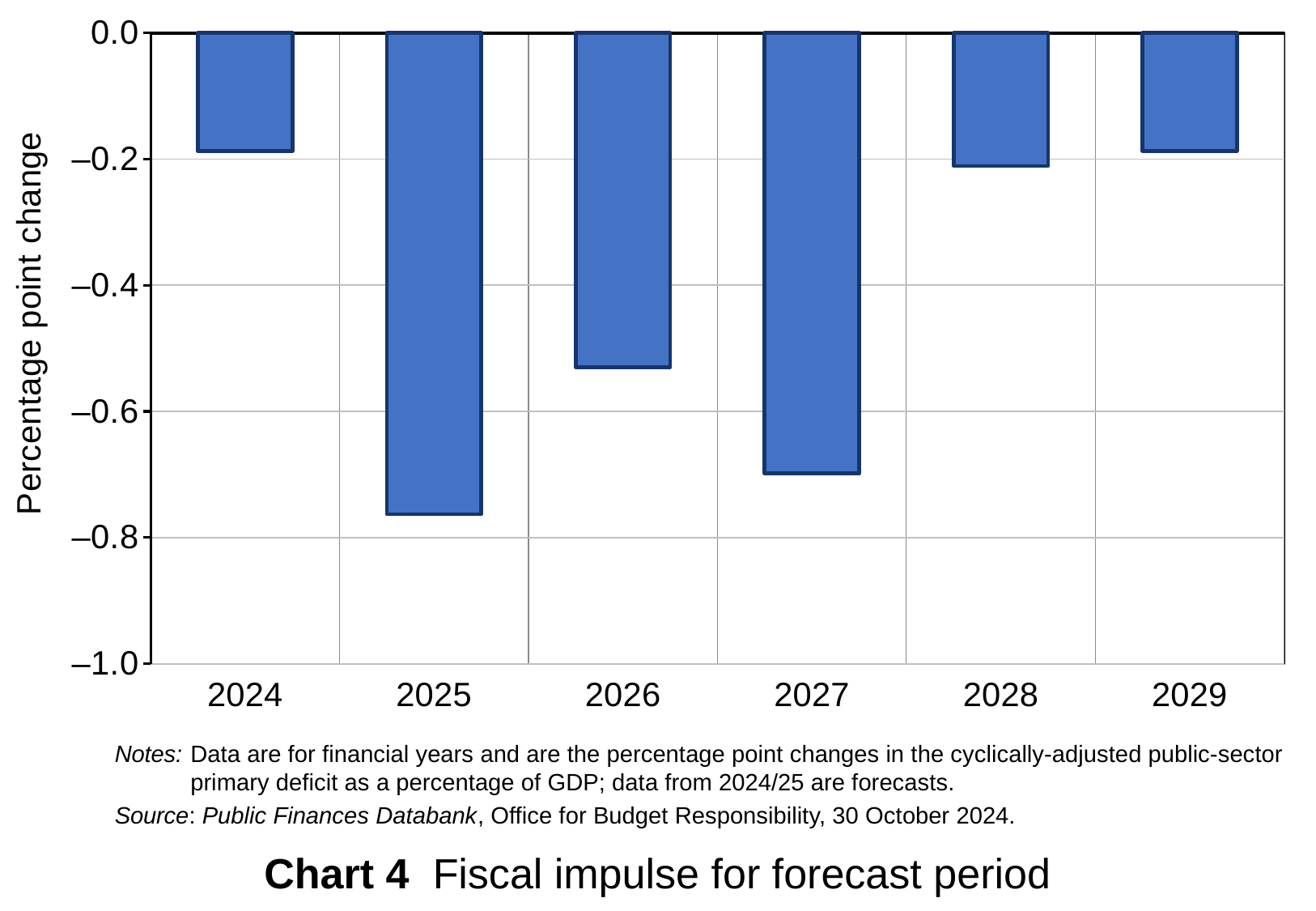
How many years are shown on the x axis of Chart 4? 6 Is the value for 2028 greater or less than -0.4? greater Which year has the lowest (most negative) value in Chart 4? 2025 Is the value for 2025 greater or less than -0.6? less Is the value for 2026 greater or less than -0.4? less What kind of chart is Chart 4? bar chart What is the label on the y axis of the chart? Percentage point change What is the title of the chart? Chart 4 Fiscal impulse for forecast period Which year has the more negative value, 2026 or 2027? 2027 Which year has the more negative value, 2025 or 2027? 2025